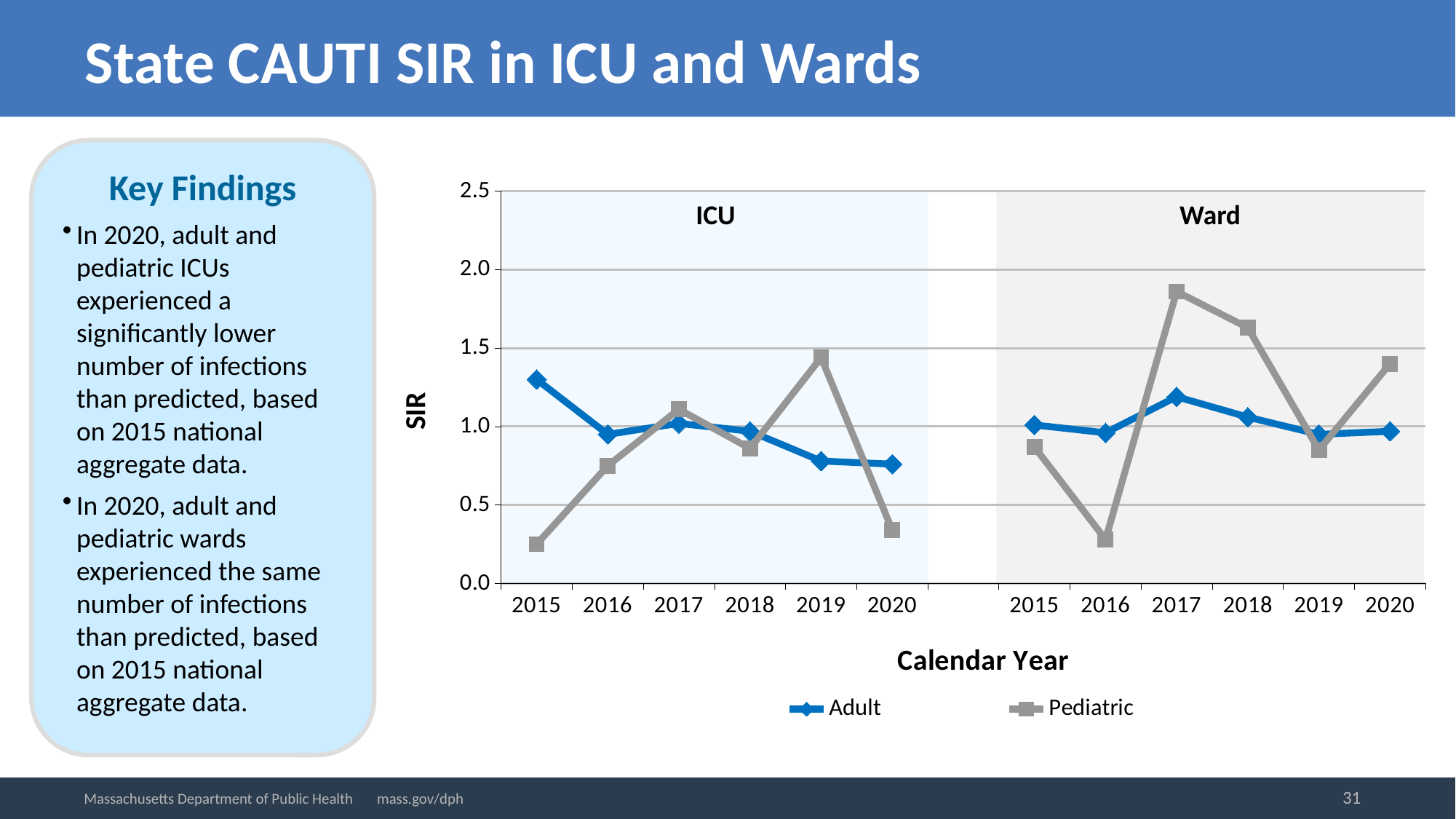
In the Ward panel for 2018, which series has the larger SIR, Adult or Pediatric? Pediatric In the Ward panel, which year has the lowest Pediatric SIR? 2016 In the ICU panel for 2020, which series has the larger SIR, Adult or Pediatric? Adult How many series does the legend list? 2 What is the title of the x axis? Calendar Year In the ICU panel, is the Adult value for 2015 greater or less than 1.0? greater What are the two series named in the legend? Adult and Pediatric In the ICU panel, is the Pediatric value for 2015 greater or less than 0.5? less In the ICU panel, which year has the highest Pediatric SIR? 2019 What kind of chart is shown on the slide? line chart In the Ward panel, is the Pediatric value for 2017 greater or less than 1.5? greater In the ICU panel, which year has the highest Adult SIR? 2015